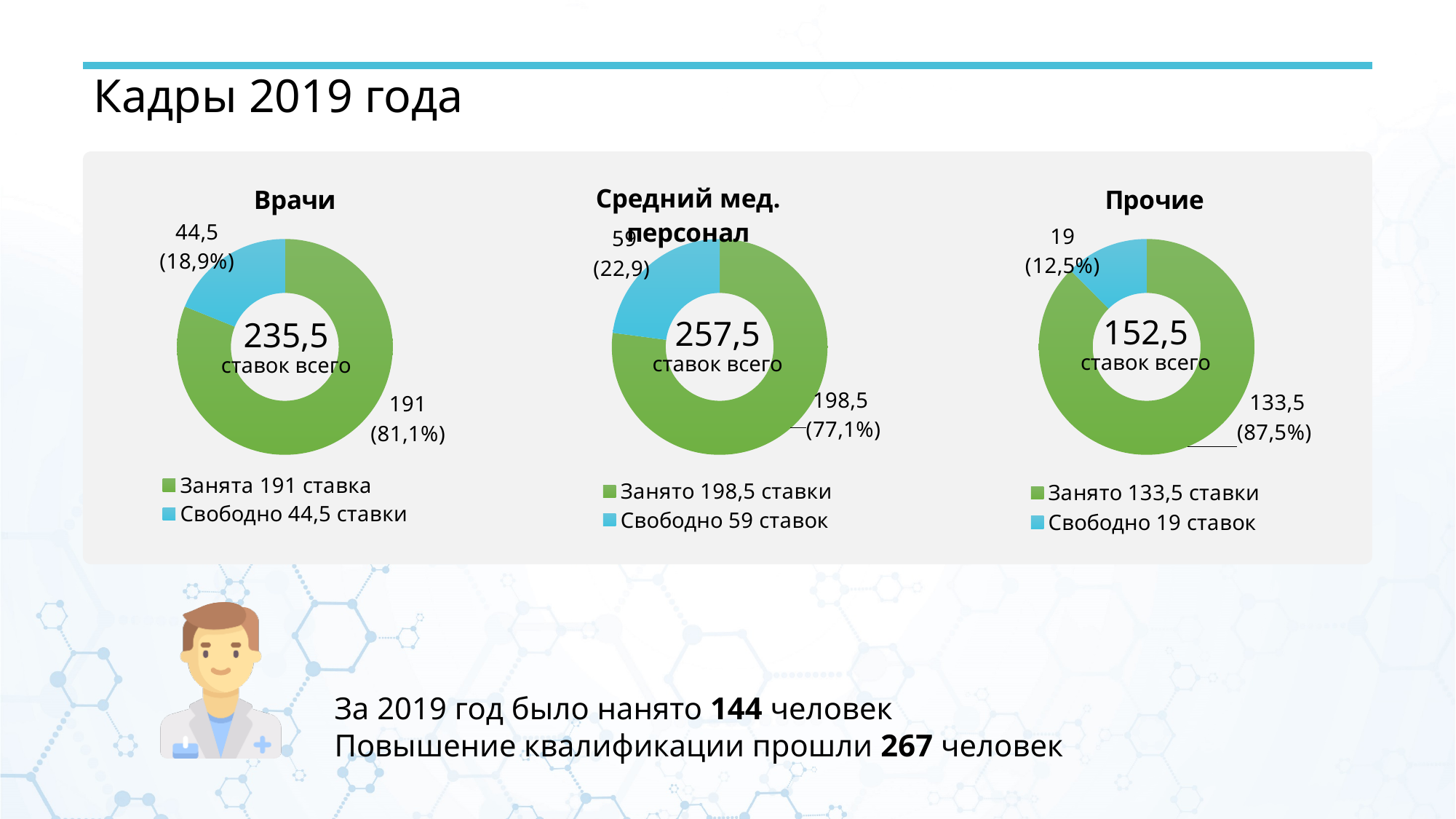
In the 'Средний мед. персонал' chart, what share of positions is occupied (Занято)? 77,1% In the 'Врачи' chart, what is the total number of positions shown in the centre? 235,5 In the 'Врачи' chart, what share of positions is free (Свободно)? 18,9% In the 'Средний мед. персонал' chart, what is the difference between occupied and free positions? 139,5 In the 'Прочие' chart, how many positions are occupied (Занято)? 133,5 In the 'Врачи' chart, how many positions are occupied (Занята)? 191 How many entries does the legend of the 'Прочие' chart list? 2 In the 'Прочие' chart, what share of positions is free (Свободно)? 12,5% In the 'Средний мед. персонал' chart, how many positions are free (Свободно)? 59 In the 'Прочие' chart, what is the total number of positions shown in the centre? 152,5 What type of chart is used for 'Врачи'? Doughnut (pie) chart Which chart has the larger free-position value: 'Врачи' or 'Средний мед. персонал'? Средний мед. персонал